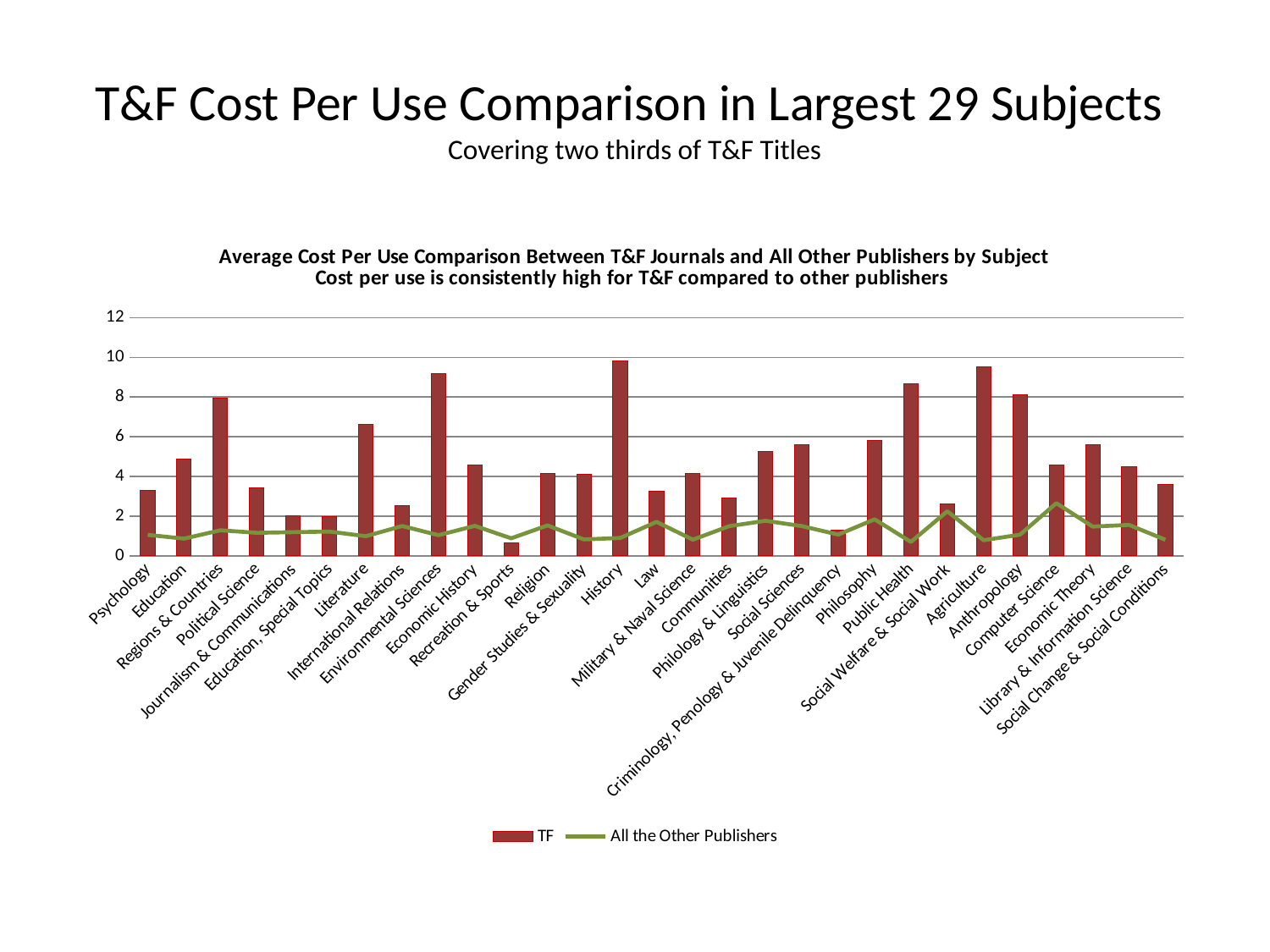
Is the TF value for Environmental Sciences greater or less than 8? greater How many subjects are shown on the x axis of the chart? 29 Which has the higher TF cost per use, Public Health or Philosophy? Public Health Is the TF value for Political Science greater or less than 4? less Which subject has the lowest TF cost per use? Recreation & Sports What are the two series named in the chart legend? TF and All the Other Publishers Is the TF value for Recreation & Sports greater or less than 2? less How many series does the chart legend list? 2 What kind of chart is used to plot the TF series? bar chart Which has the higher TF cost per use, Agriculture or Social Welfare & Social Work? Agriculture Which has the higher TF cost per use, Regions & Countries or Political Science? Regions & Countries